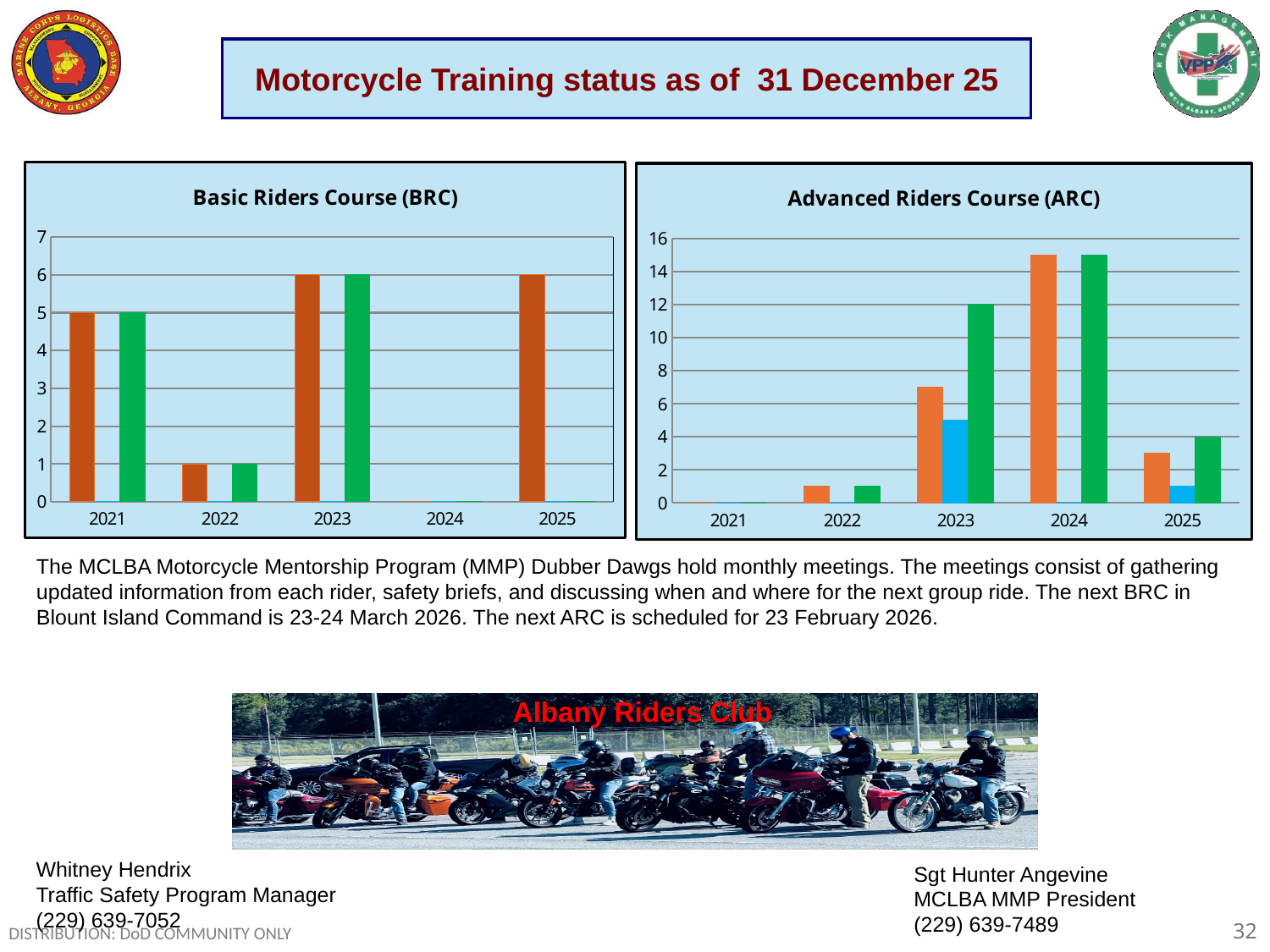
In the Basic Riders Course (BRC) chart, which year has the lowest values? 2024 In the Advanced Riders Course (ARC) chart, for 2023, which is larger: the green bar or the orange bar? green bar In the Basic Riders Course (BRC) chart, what is the value of the orange bar for 2021? 5 How many years are shown on the x axis of the Basic Riders Course (BRC) chart? 5 In the Basic Riders Course (BRC) chart, what is the difference between the orange bar for 2023 and the orange bar for 2022? 5 What kind of chart is the Basic Riders Course (BRC) chart? bar chart In the Advanced Riders Course (ARC) chart, is the value of the orange bar for 2024 greater or less than 14? greater In the Advanced Riders Course (ARC) chart, what is the value of the green bar for 2025? 4 In the Basic Riders Course (BRC) chart, what is the value of the orange bar for 2023? 6 In the Basic Riders Course (BRC) chart, what is the value of the green bar for 2022? 1 In the Advanced Riders Course (ARC) chart, what is the value of the green bar for 2023? 12 In the Advanced Riders Course (ARC) chart, which year has the tallest bars? 2024